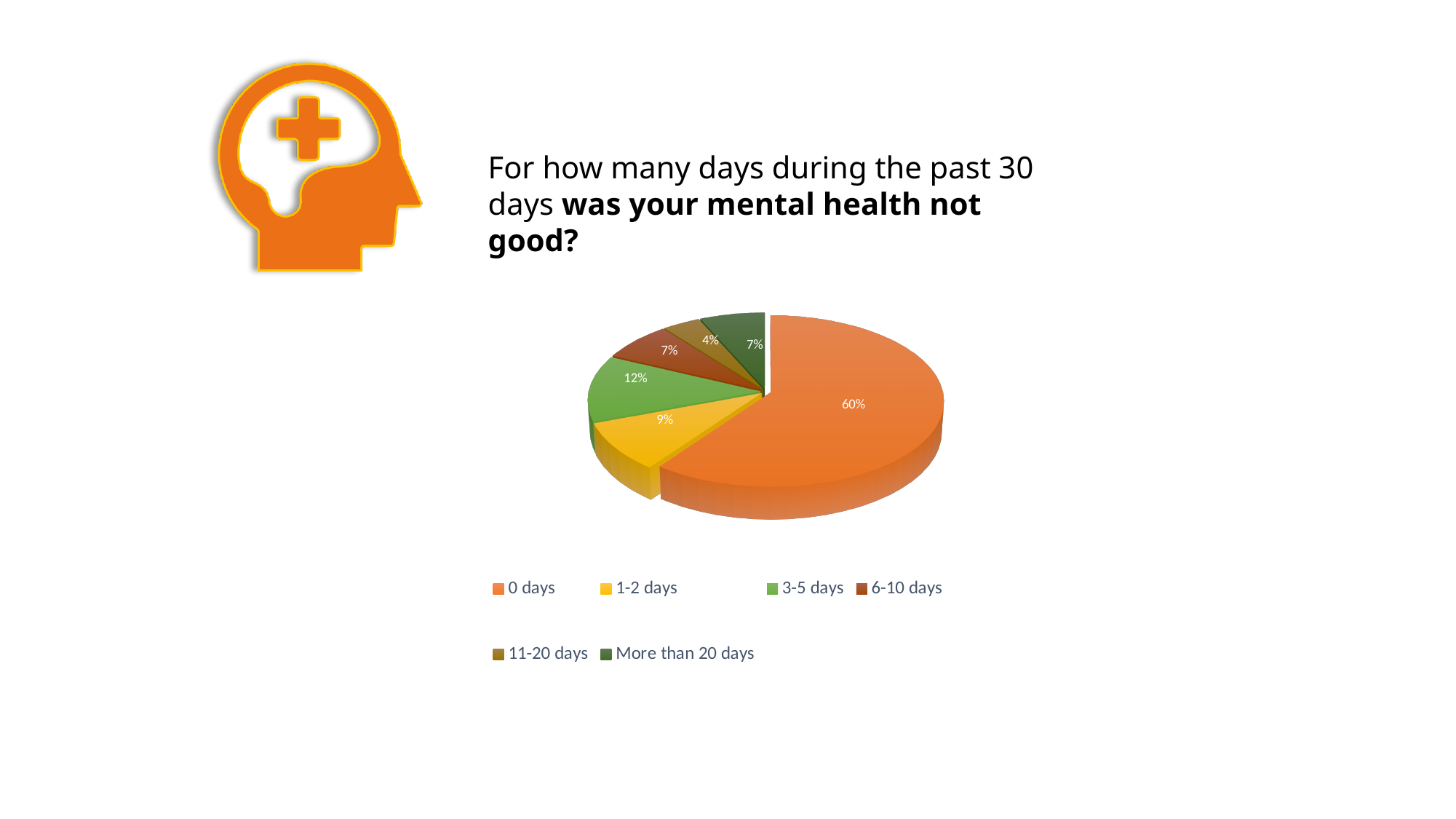
What kind of chart is shown on the slide? Pie chart What colour is the "0 days" slice in the pie chart? Orange What share of the pie does the "0 days" slice represent? 60% Which category has the largest slice of the pie? 0 days Which is larger, the "3-5 days" slice or the "1-2 days" slice? 3-5 days How many categories does the pie chart show? 6 What percentage is shown for the "1-2 days" category? 9% What percentage is shown for the "More than 20 days" category? 7% What percentage is shown for the "3-5 days" category? 12% What percentage is shown for the "11-20 days" category? 4% Which category has the smallest slice of the pie? 11-20 days What is the difference in percentage points between the "0 days" slice and the "3-5 days" slice? 48